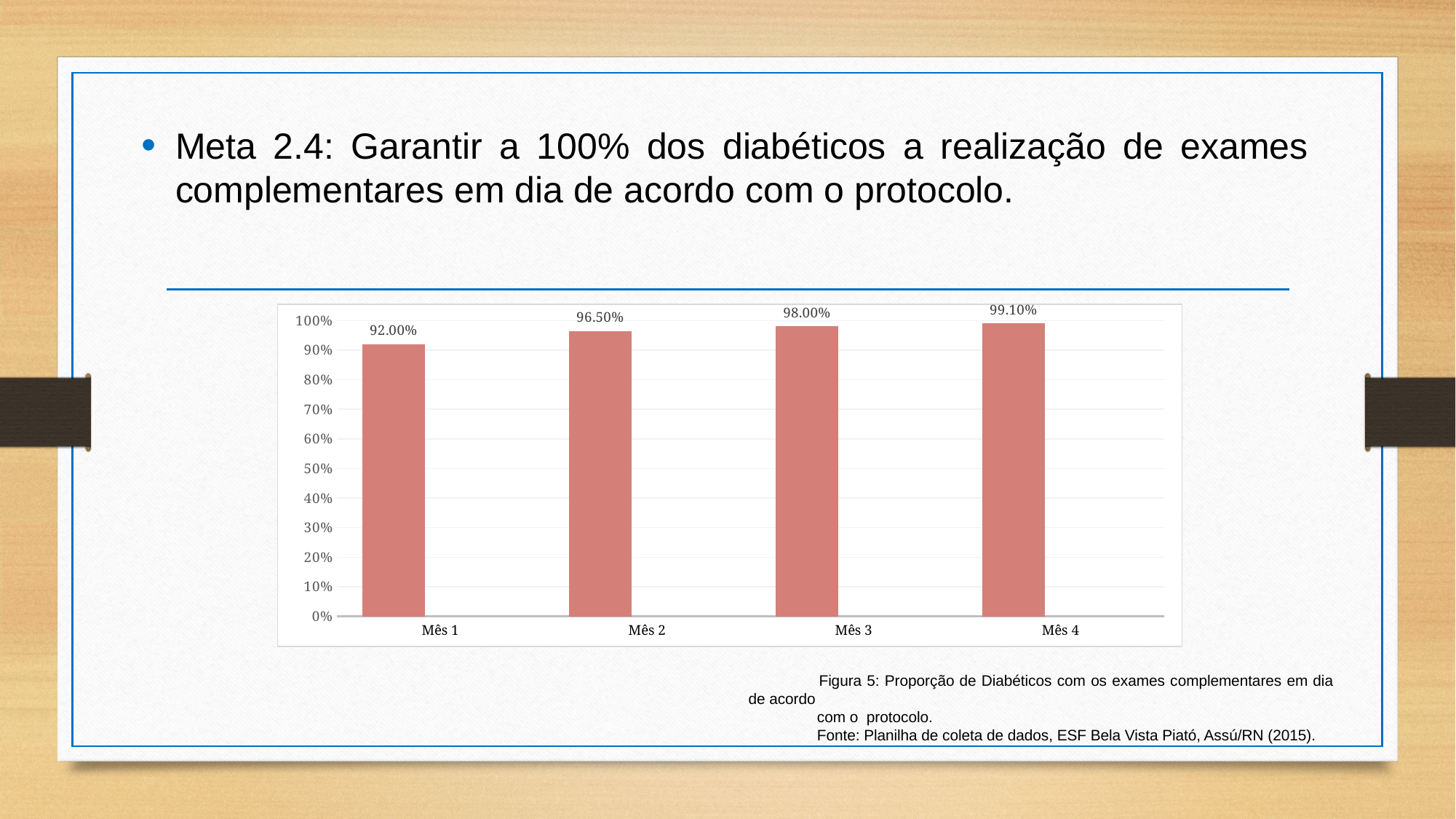
How many months are shown on the x axis? 4 What is the value for Mês 4? 99.10% Which month has the highest value? Mês 4 Which is larger, the value for Mês 2 or the value for Mês 3? Mês 3 Which month has the lowest value? Mês 1 Do the values rise or fall from Mês 1 to Mês 4? rise What is the value for Mês 1? 92.00% What is the difference between the values for Mês 2 and Mês 1? 4.50% Is the value for Mês 1 greater or less than 90%? greater What is the value for Mês 3? 98.00% What is the difference between the values for Mês 4 and Mês 3? 1.10% What kind of chart is shown on the slide? bar chart